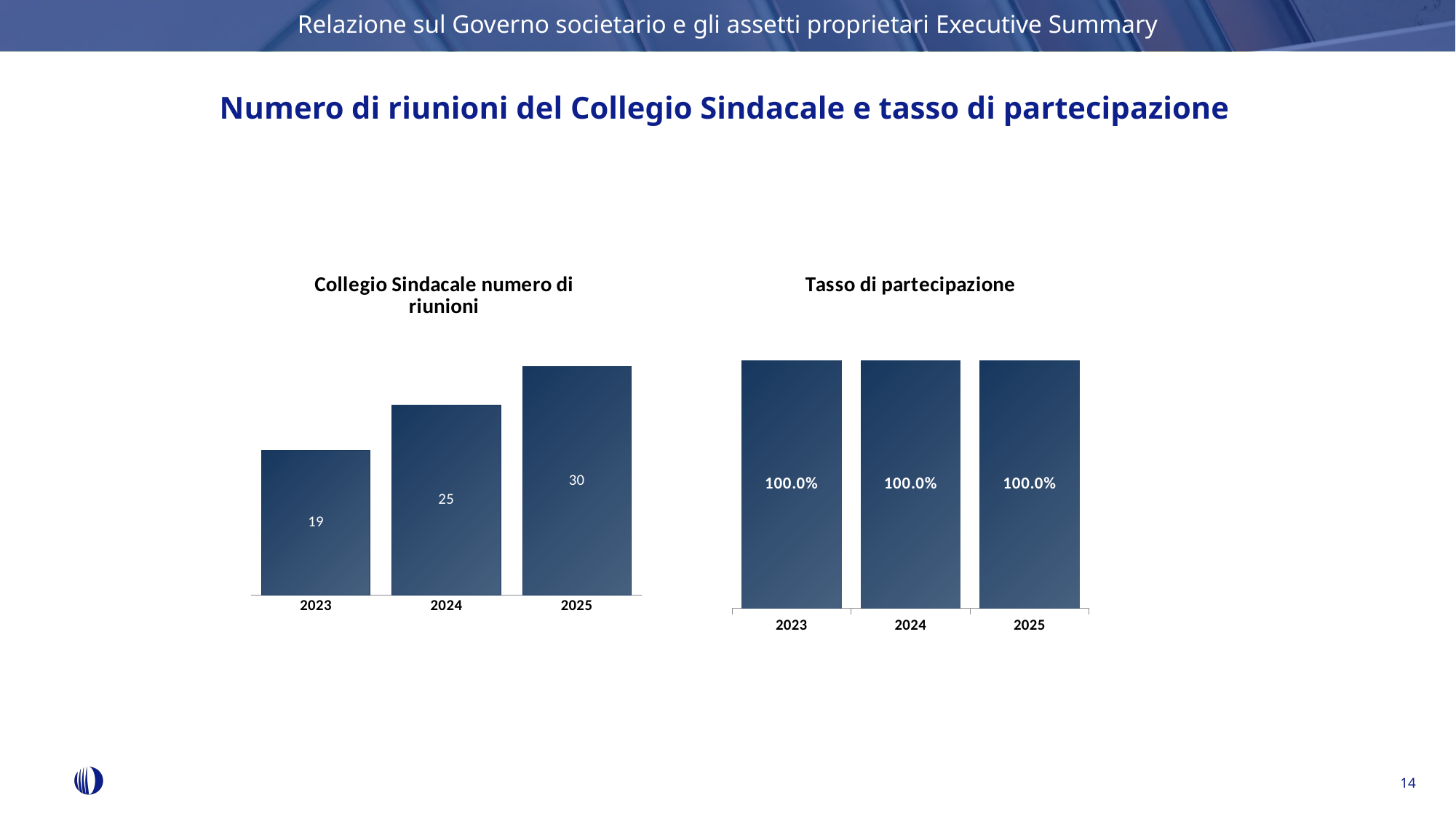
In the 'Collegio Sindacale numero di riunioni' chart, which is larger, the value for 2024 or the value for 2025? 2025 In the 'Collegio Sindacale numero di riunioni' chart, what is the value for 2024? 25 In the 'Collegio Sindacale numero di riunioni' chart, what is the value for 2023? 19 What kind of chart is the 'Tasso di partecipazione' chart? bar chart In the 'Tasso di partecipazione' chart, what is the value for 2025? 100.0% In the 'Collegio Sindacale numero di riunioni' chart, which year has the highest value? 2025 How many years are shown in the 'Collegio Sindacale numero di riunioni' chart? 3 In the 'Tasso di partecipazione' chart, what is the value for 2023? 100.0% In the 'Collegio Sindacale numero di riunioni' chart, do the values rise or fall from 2023 to 2025? rise In the 'Collegio Sindacale numero di riunioni' chart, what is the difference between the values for 2025 and 2023? 11 What is the title of the chart on the right side of the slide? Tasso di partecipazione In the 'Collegio Sindacale numero di riunioni' chart, which year has the lowest value? 2023